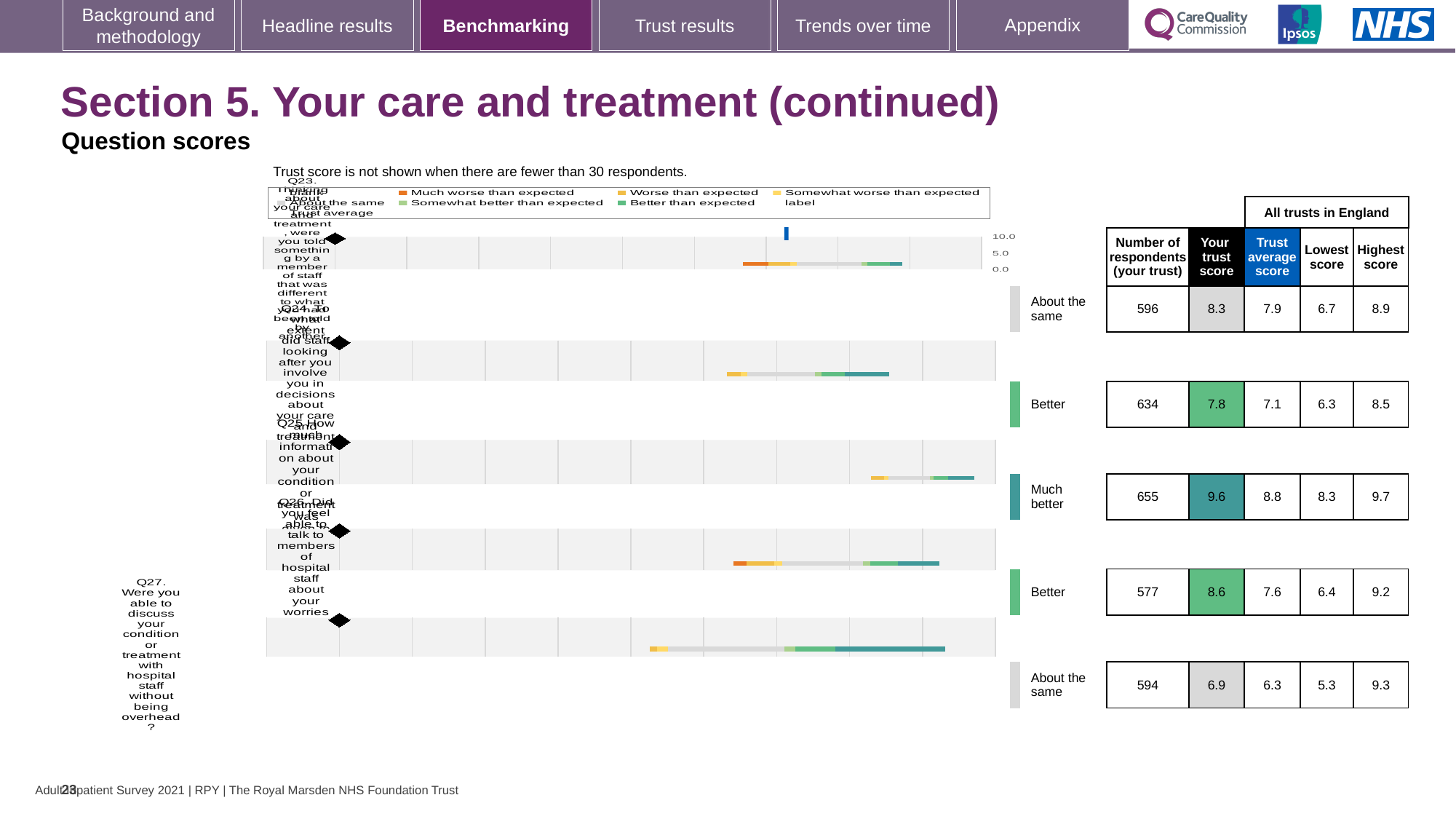
What is the highest score across all trusts in England for Q27? 9.3 What is the trust score for Q25 (how much information about your condition or treatment was given)? 9.6 What is the trust score for Q27 (able to discuss your condition or treatment without being overheard)? 6.9 How many questions are plotted on this slide? 5 What benchmark category is shown for Q25? Much better For Q23, which is larger: the trust score or the trust average score? Trust score What is the trust average score for Q24 (did staff involve you in decisions about your care and treatment)? 7.1 What is the difference between the trust score and the trust average score for Q25? 0.8 What kind of chart is used to show the question scores? Bar chart Which question has the highest trust score on this slide? Q25 How many respondents answered Q26 (able to talk to hospital staff about your worries)? 577 Which question has the lowest trust score on this slide? Q27